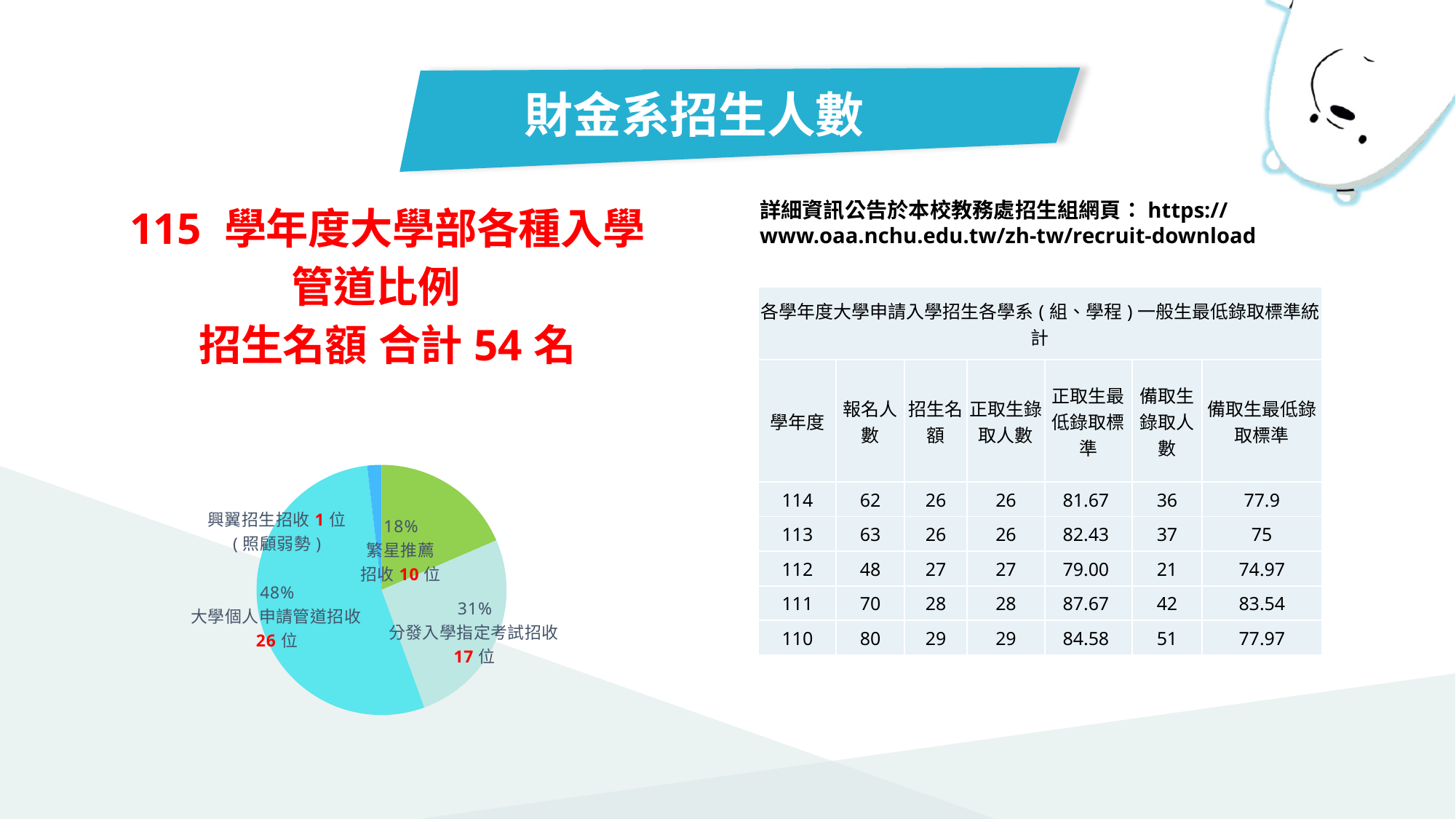
How many slices does the pie chart have? 4 What share of the pie does 分發入學指定考試招收 take? 31% What share of the pie does 大學個人申請管道招收 take? 48% Which admission channel has the smallest slice in the pie chart? 興翼招生招收 (照顧弱勢) How many students (位) are admitted through 興翼招生 (照顧弱勢) according to the pie chart? 1 位 What kind of chart is shown on the slide? pie chart How many students (位) are admitted through 大學個人申請管道 according to the pie chart? 26 位 What is the difference in admitted students between 大學個人申請管道 (26 位) and 繁星推薦 (10 位)? 16 位 How many students (位) are admitted through 分發入學指定考試 according to the pie chart? 17 位 Which admission channel has the largest slice in the pie chart? 大學個人申請管道招收 What share of the pie does 繁星推薦招收 take? 18% How many students (位) are admitted through 繁星推薦 according to the pie chart? 10 位